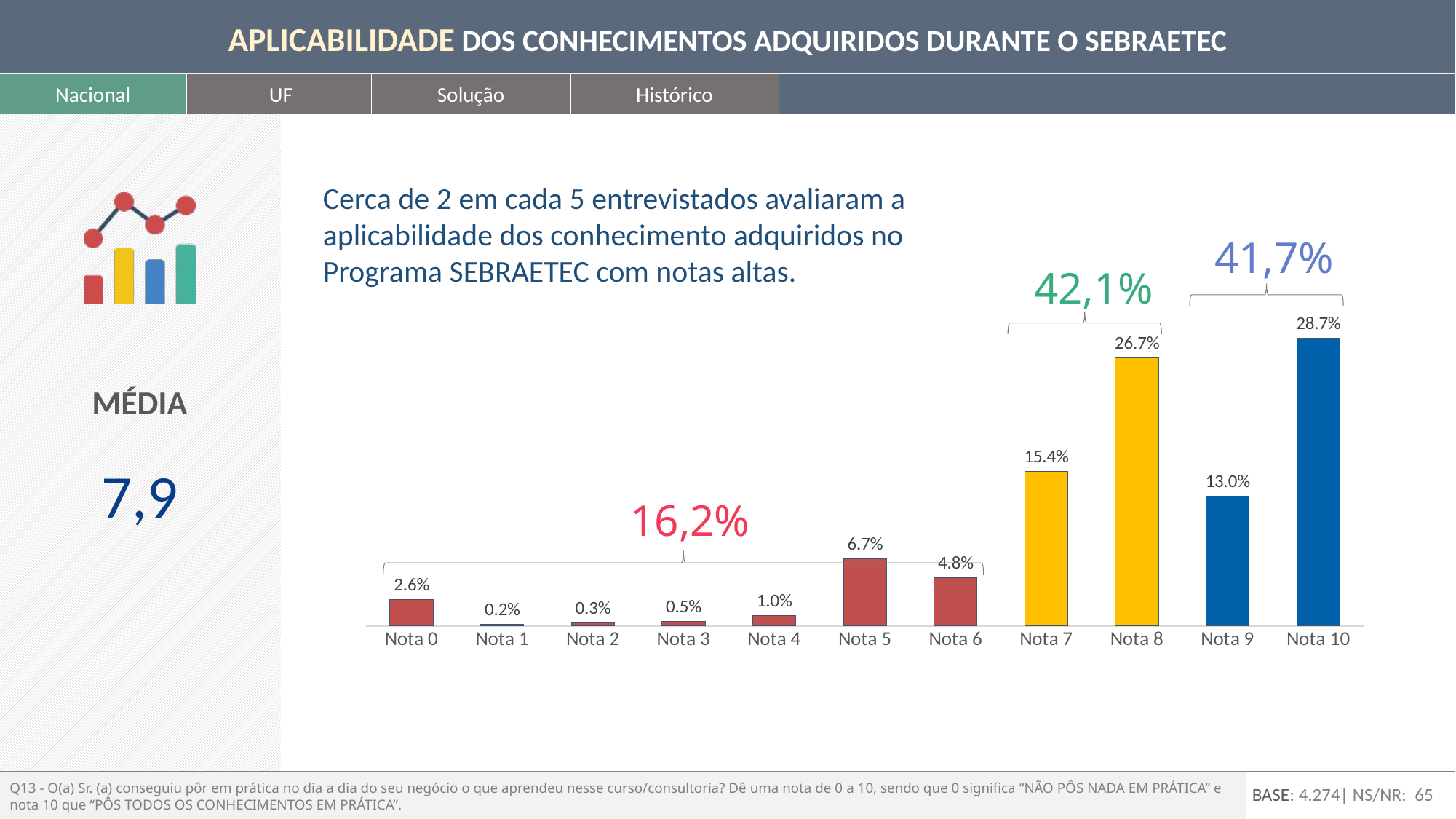
What is the difference between the values for Nota 10 and Nota 8? 2.0% What is the value for Nota 10? 28.7% What colour are the bars for Nota 9 and Nota 10? Blue What is the combined share shown above the bracket grouping Nota 7 and Nota 8? 42,1% Which category has the lowest value? Nota 1 What is the value for Nota 8? 26.7% Which is larger, the value for Nota 5 or the value for Nota 6? Nota 5 What is the difference between the values for Nota 7 and Nota 9? 2.4% How many categories are shown on the x axis? 11 What is the value for Nota 0? 2.6% What kind of chart is shown on the slide? Bar chart Which category has the highest value? Nota 10